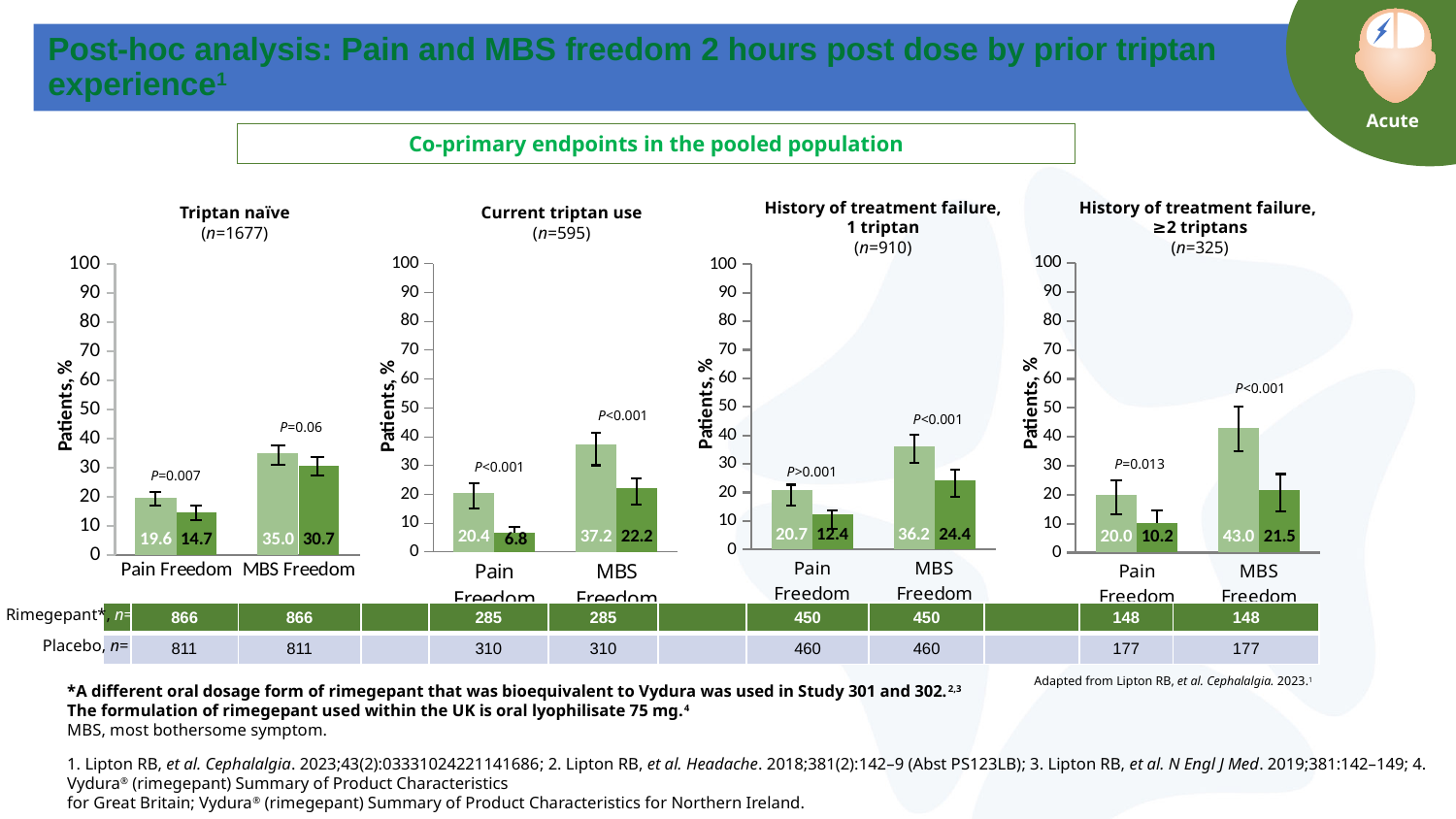
In the 'History of treatment failure, 1 triptan' chart, what is the rimegepant value for MBS Freedom? 36.2 What type of chart is used for the 'Triptan naïve' panel? Bar chart In the 'Current triptan use' chart, what is the difference between the rimegepant and placebo values for MBS Freedom? 15.0 In the 'History of treatment failure, ≥2 triptans' chart, what is the difference between the rimegepant and placebo values for Pain Freedom? 9.8 In the 'History of treatment failure, ≥2 triptans' chart, what is the rimegepant value for MBS Freedom? 43.0 In the 'Triptan naïve' chart, what is the rimegepant value for Pain Freedom? 19.6 In the 'Triptan naïve' chart, which bar is the lowest? Placebo, Pain Freedom In the 'Current triptan use' chart, which bar is the highest? Rimegepant, MBS Freedom In the 'Triptan naïve' chart, what is the placebo value for MBS Freedom? 30.7 In the 'Current triptan use' chart, what is the placebo value for Pain Freedom? 6.8 How many charts are shown on the slide? 4 In the 'History of treatment failure, 1 triptan' chart, which is larger for Pain Freedom: rimegepant or placebo? Rimegepant